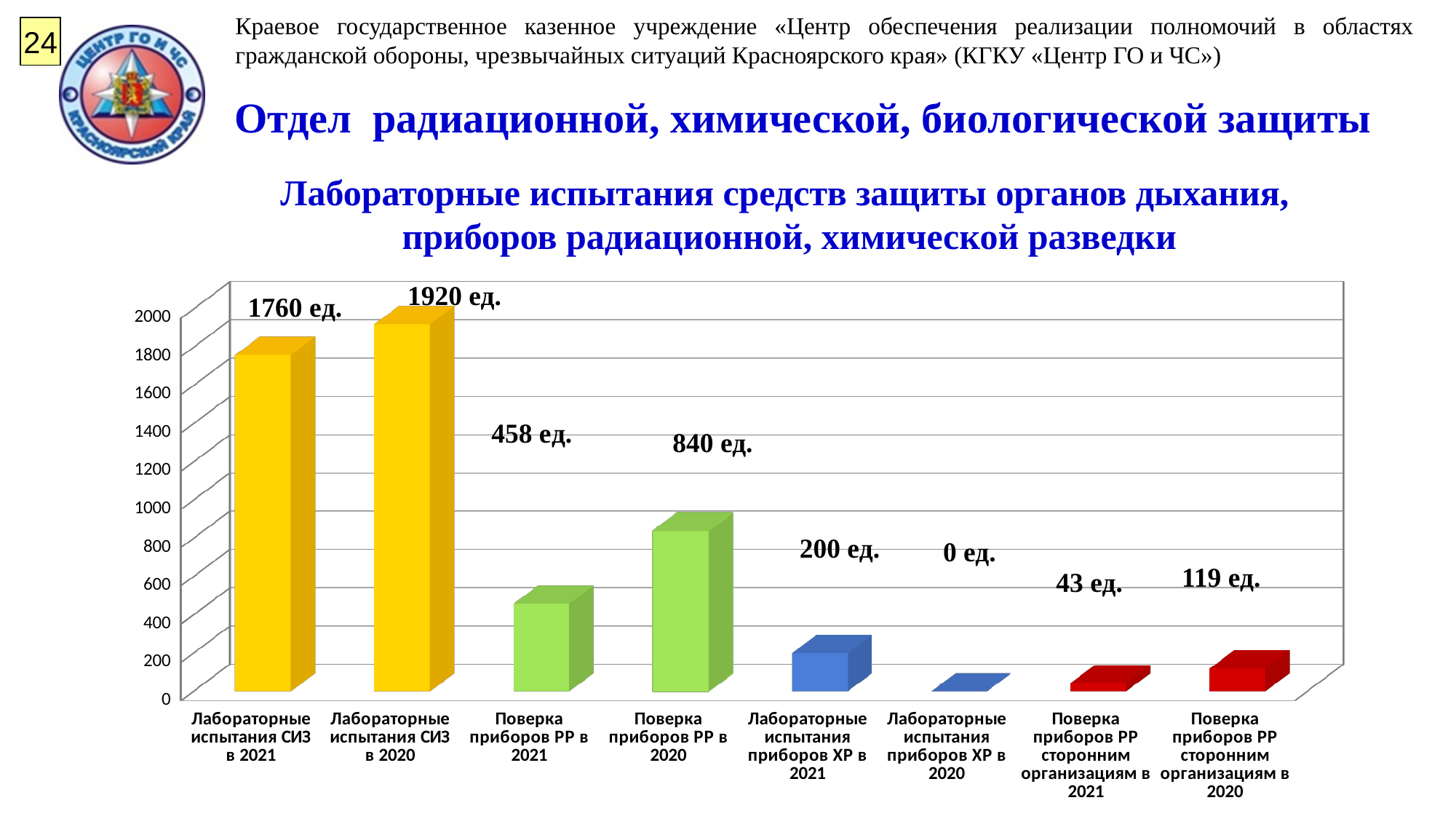
What is the difference between «Лабораторные испытания СИЗ в 2020» and «Лабораторные испытания СИЗ в 2021»? 160 ед. What is the difference between «Поверка приборов РР в 2020» and «Поверка приборов РР в 2021»? 382 ед. What value is shown for «Лабораторные испытания приборов ХР в 2020»? 0 ед. Is the value for «Лабораторные испытания приборов ХР в 2021» greater or less than 400? less What value is shown for «Поверка приборов РР сторонним организациям в 2021»? 43 ед. What kind of chart is shown on the slide? bar chart Which category has the lowest value? Лабораторные испытания приборов ХР в 2020 How many categories are shown on the chart? 8 Which is larger: «Поверка приборов РР сторонним организациям в 2020» or «Поверка приборов РР сторонним организациям в 2021»? Поверка приборов РР сторонним организациям в 2020 What value is shown for «Поверка приборов РР в 2020»? 840 ед. Which category has the highest value? Лабораторные испытания СИЗ в 2020 What value is shown for «Лабораторные испытания СИЗ в 2021»? 1760 ед.